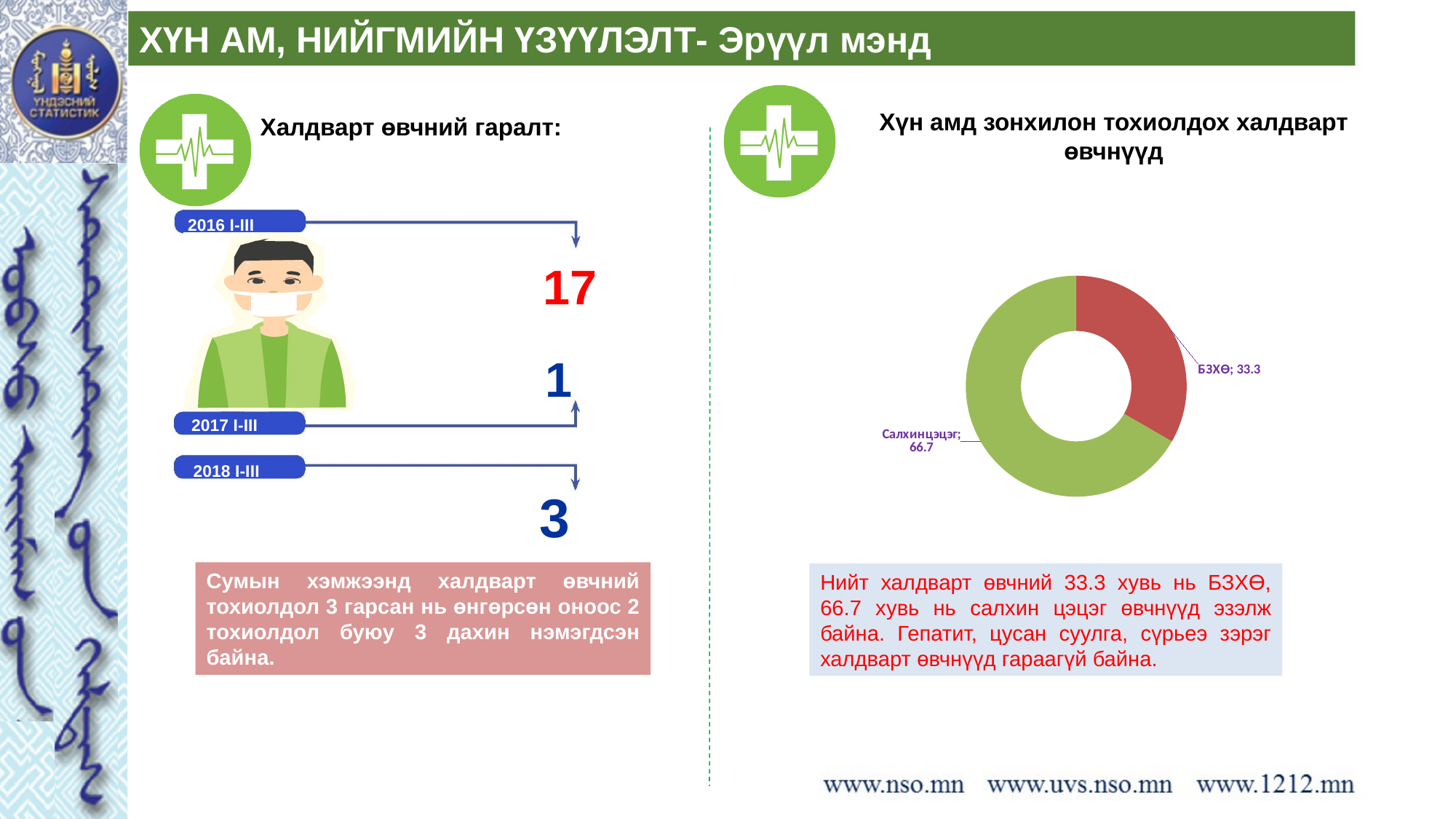
In the donut chart on the right, which is larger: БЗХӨ or Салхинцэцэг? Салхинцэцэг In the donut chart on the right, which category has the largest share? Салхинцэцэг In the donut chart on the right, how many categories are shown? 2 In the donut chart on the right, what colour is the БЗХӨ slice? Red In the left infographic 'Халдварт өвчний гаралт', what is the value for 2016 I-III? 17 In the donut chart on the right, what is the difference between the values for Салхинцэцэг and БЗХӨ? 33.4 What kind of chart is shown under the title 'Хүн амд зонхилон тохиолдох халдварт өвчнүүд'? Donut (pie) chart In the donut chart on the right, what is the value for Салхинцэцэг? 66.7 In the donut chart on the right, what is the value for БЗХӨ? 33.3 In the left infographic 'Халдварт өвчний гаралт', what is the value for 2018 I-III? 3 In the donut chart on the right, which category has the smallest share? БЗХӨ In the donut chart on the right, what colour is the Салхинцэцэг slice? Green